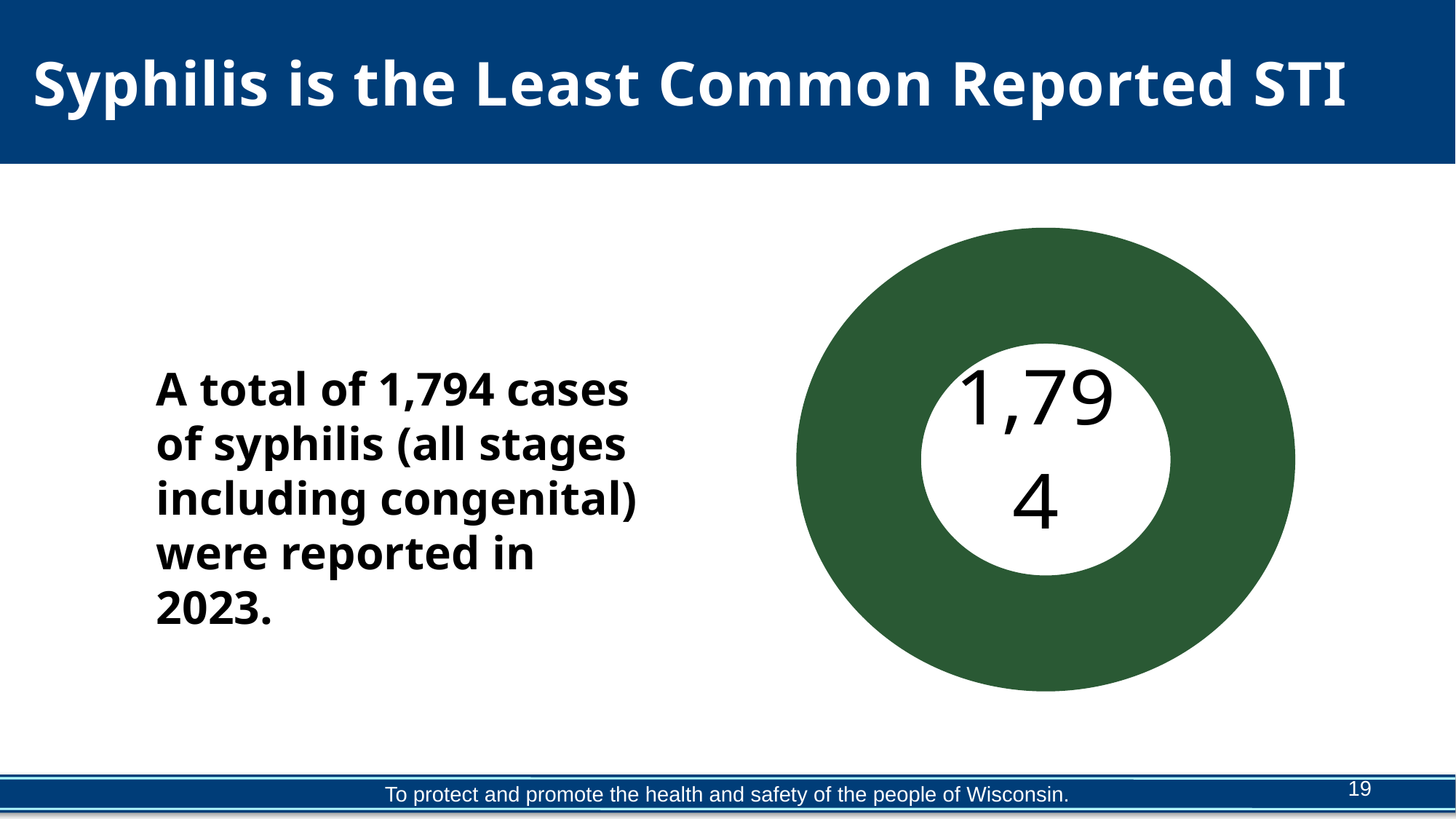
Does the doughnut chart display a legend? No What kind of chart is shown on the slide? doughnut chart What number is displayed in the centre of the doughnut chart? 1,794 What share of the doughnut chart does the single slice occupy? 100% What colour is the ring of the doughnut chart? dark green How many slices does the doughnut chart contain? 1 Is the value shown in the doughnut chart greater or less than 1,000? greater